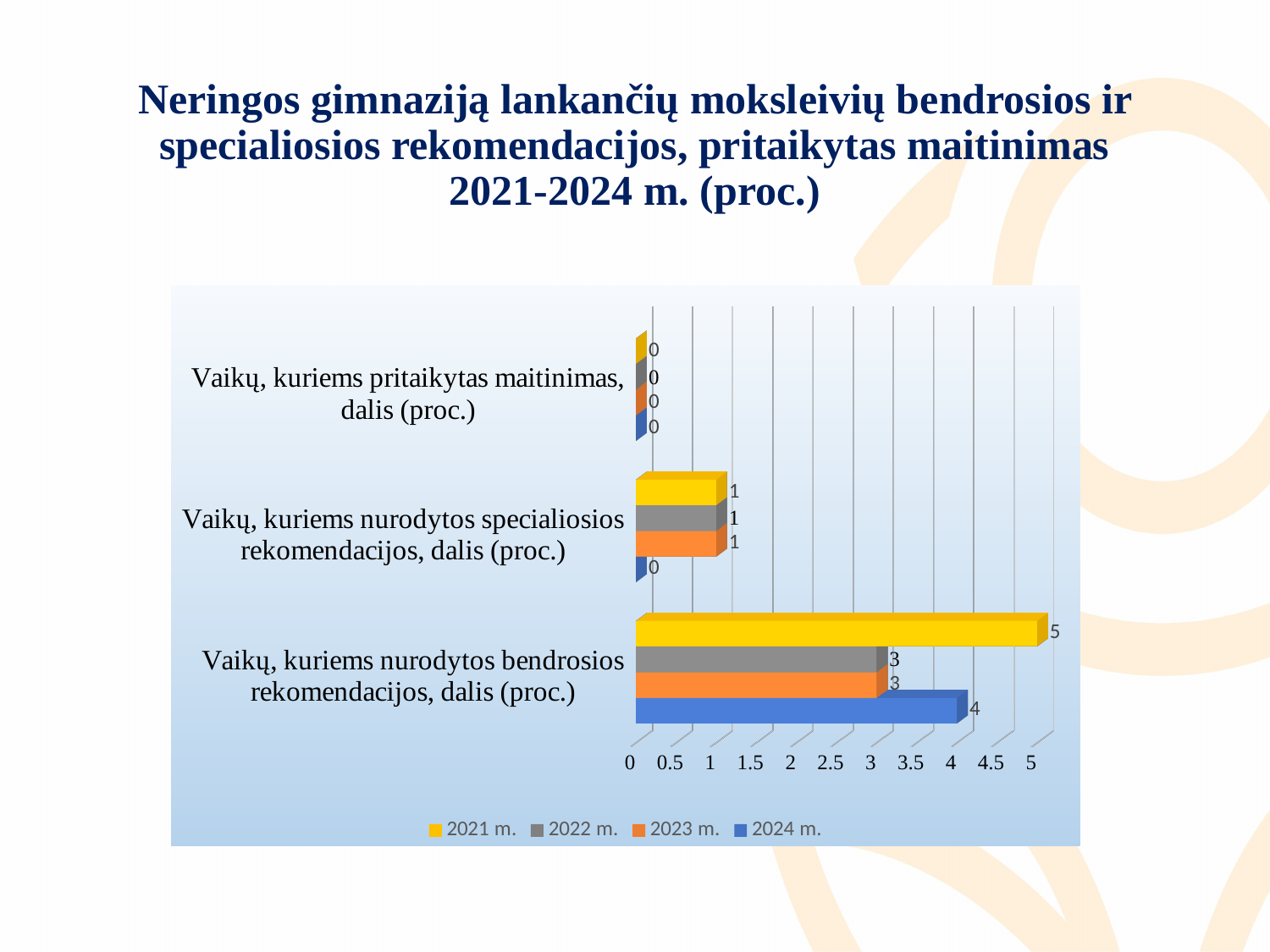
How many categories are shown on the chart? 3 Which series has the highest value in the category "Vaikų, kuriems nurodytos bendrosios rekomendacijos, dalis (proc.)"? 2021 m. What is the value for 2023 m. in the category "Vaikų, kuriems nurodytos specialiosios rekomendacijos, dalis (proc.)"? 1 What is the value for 2022 m. in the category "Vaikų, kuriems pritaikytas maitinimas, dalis (proc.)"? 0 What is the value for 2024 m. in the category "Vaikų, kuriems nurodytos bendrosios rekomendacijos, dalis (proc.)"? 4 What is the difference between the 2021 m. and 2022 m. values in the category "Vaikų, kuriems nurodytos bendrosios rekomendacijos, dalis (proc.)"? 2 How many series does the legend list? 4 Which colour represents the 2023 m. series in the legend? Orange In the category "Vaikų, kuriems nurodytos bendrosios rekomendacijos, dalis (proc.)", which is larger: the 2023 m. value or the 2024 m. value? 2024 m. What is the value for 2021 m. in the category "Vaikų, kuriems nurodytos bendrosios rekomendacijos, dalis (proc.)"? 5 What is the value for 2024 m. in the category "Vaikų, kuriems nurodytos specialiosios rekomendacijos, dalis (proc.)"? 0 What kind of chart is shown on the slide? Bar chart